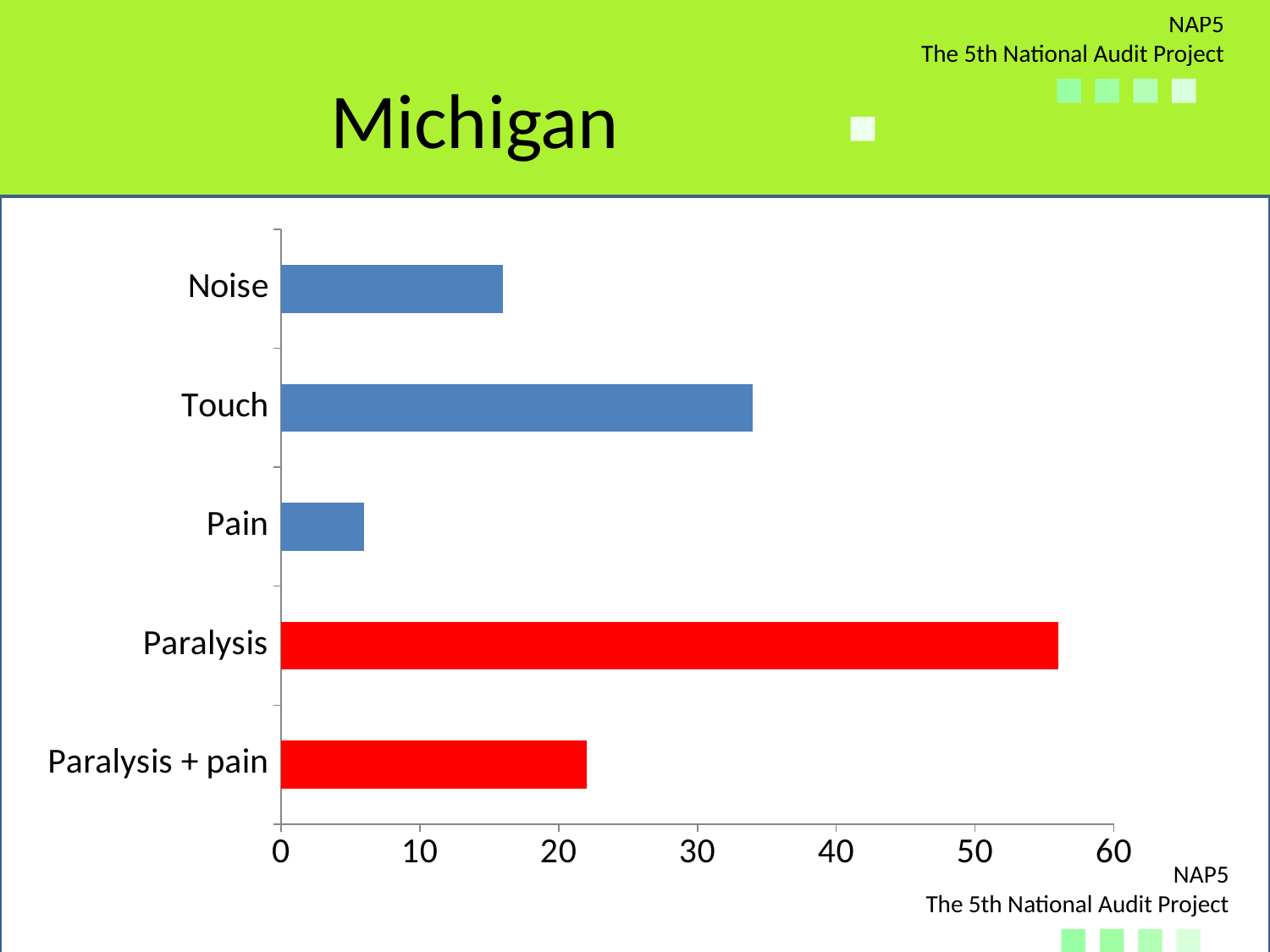
What colour are the bars for Paralysis and Paralysis + pain? red Is the value for Noise greater or less than 20? less How many categories are plotted in the chart? 5 What is the title of the slide containing the chart? Michigan Is the value for Touch greater or less than 30? greater Is the value for Paralysis greater or less than 50? greater Which is larger, the value for Touch or the value for Noise? Touch Which category has the lowest value? Pain What kind of chart is shown on the slide? bar chart Which category has the highest value? Paralysis